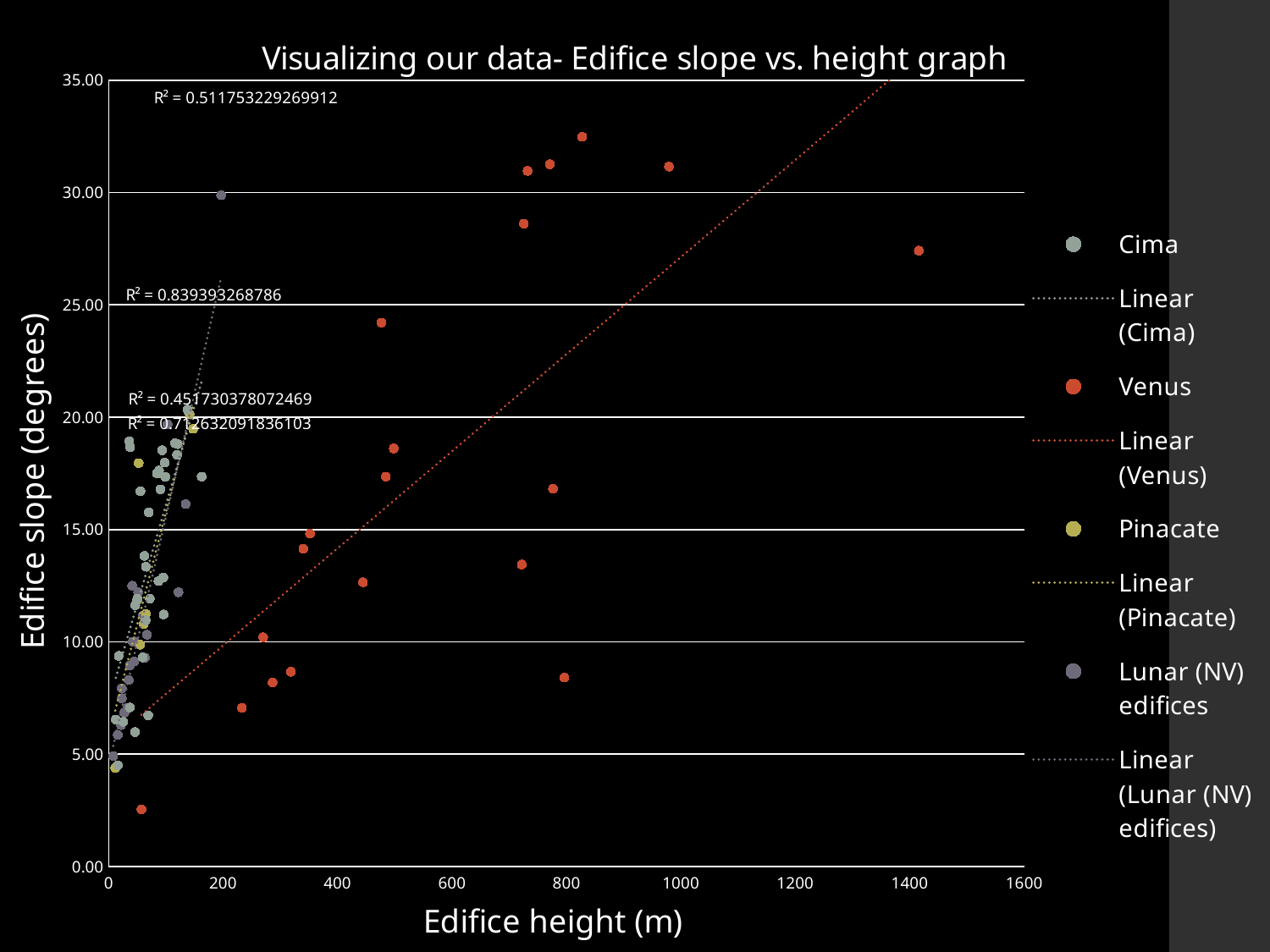
Which series contains the point with the lowest edifice slope? Venus Does the Linear (Venus) trendline rise or fall as edifice height increases? rises Which series contains the point with the greatest edifice height? Venus What kind of chart is shown on the slide? scatter chart What is the label of the x axis? Edifice height (m) How many data series (excluding the linear trendlines) does the legend list? 4 Is the slope value for the Lunar (NV) edifices point near 200 m height greater or less than 25.00? greater What is the largest R² value printed on the chart? R² = 0.839393268786 Which series contains the point with the highest edifice slope? Venus How many entries does the chart legend list? 8 What is the title of the chart? Visualizing our data- Edifice slope vs. height graph Is the slope value for the Venus point with the greatest edifice height (around 1400 m) greater or less than 25.00? greater